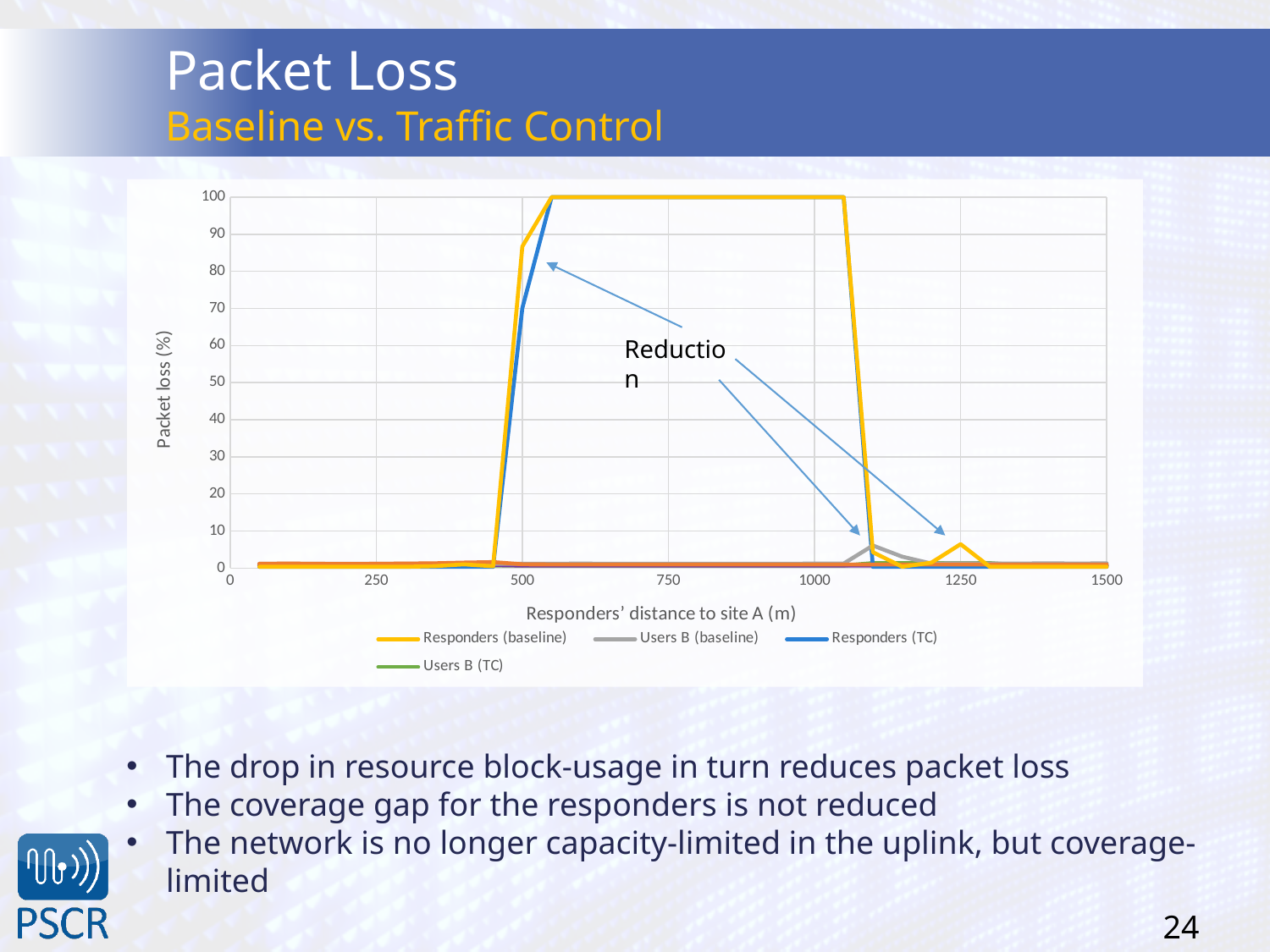
Is the packet loss for Responders (baseline) at 1250 m greater or less than 20? less Does the packet loss for Responders (baseline) rise or fall between 1000 m and 1250 m? Fall How many series does the chart legend list? 4 Does the packet loss for Responders (baseline) rise or fall between 250 m and 500 m? Rise What kind of chart is shown on the slide? Line chart Is the packet loss for Responders (TC) at 500 m greater or less than 50? greater What is the label of the horizontal axis of the chart? Responders' distance to site A (m) At 750 m, which series has the higher packet loss: Responders (baseline) or Users B (baseline)? Responders (baseline) Is the packet loss for Responders (baseline) at 250 m greater or less than 10? less What is the label of the vertical axis of the chart? Packet loss (%)